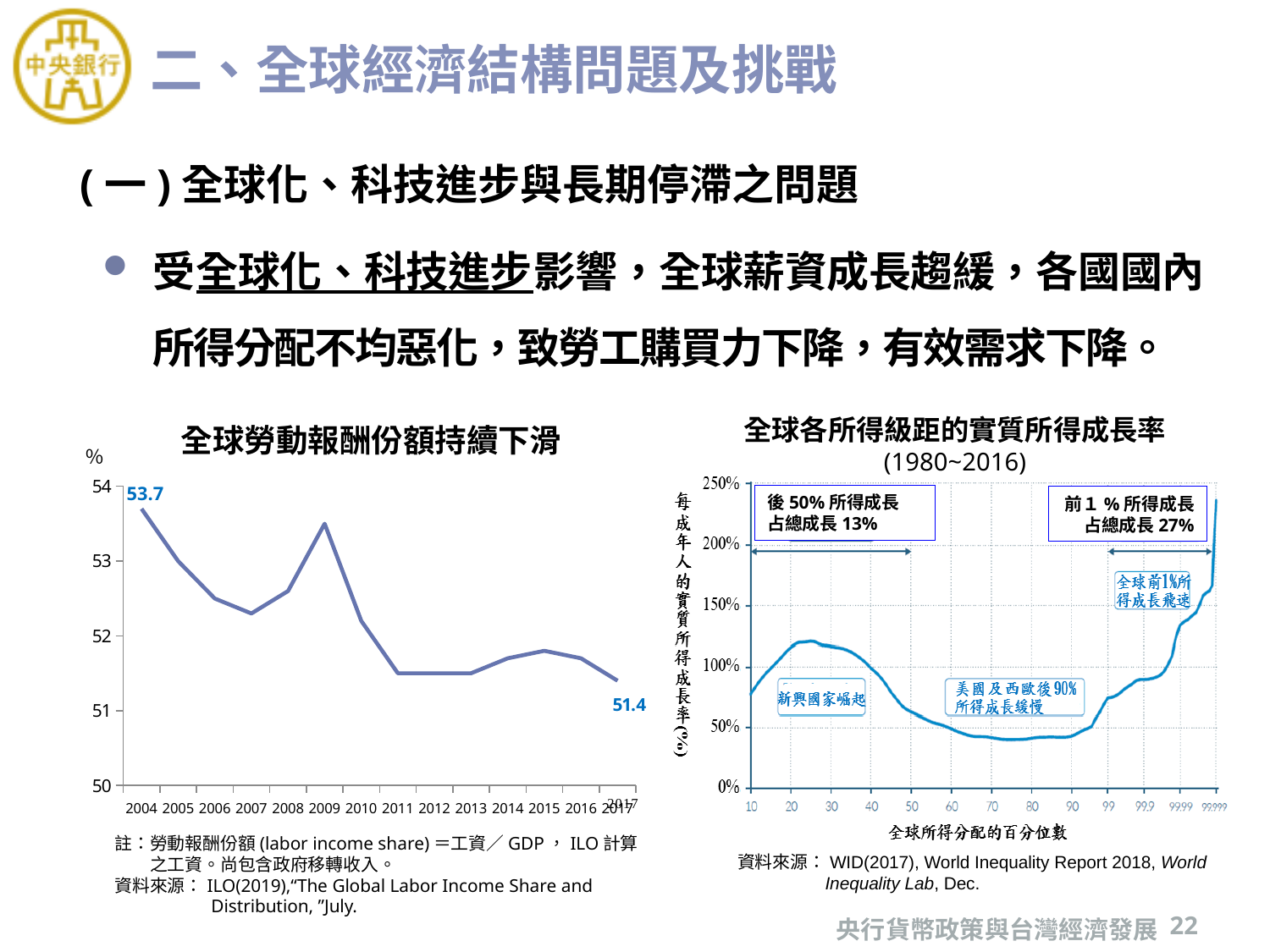
In the right chart (全球各所得級距的實質所得成長率), is the real income growth rate at the 20th percentile greater or less than 100%? greater In the left chart (全球勞動報酬份額持續下滑), what is the labor income share value for 2004? 53.7 In the left chart (全球勞動報酬份額持續下滑), what is the labor income share value for 2017? 51.4 In the left chart (全球勞動報酬份額持續下滑), which year has the larger value, 2004 or 2017? 2004 In the left chart (全球勞動報酬份額持續下滑), is the value for 2011 greater or less than 52? less In the left chart (全球勞動報酬份額持續下滑), does the labor income share overall rise or fall from 2004 to 2017? Fall In the right chart (全球各所得級距的實質所得成長率), what period does the subtitle say the data covers? 1980~2016 What kind of chart is the left chart (全球勞動報酬份額持續下滑)? Line chart In the left chart (全球勞動報酬份額持續下滑), is the value for 2009 greater or less than 53? greater In the left chart (全球勞動報酬份額持續下滑), how many years are shown on the x axis? 14 In the left chart (全球勞動報酬份額持續下滑), what is the difference between the 2004 value and the 2017 value? 2.3